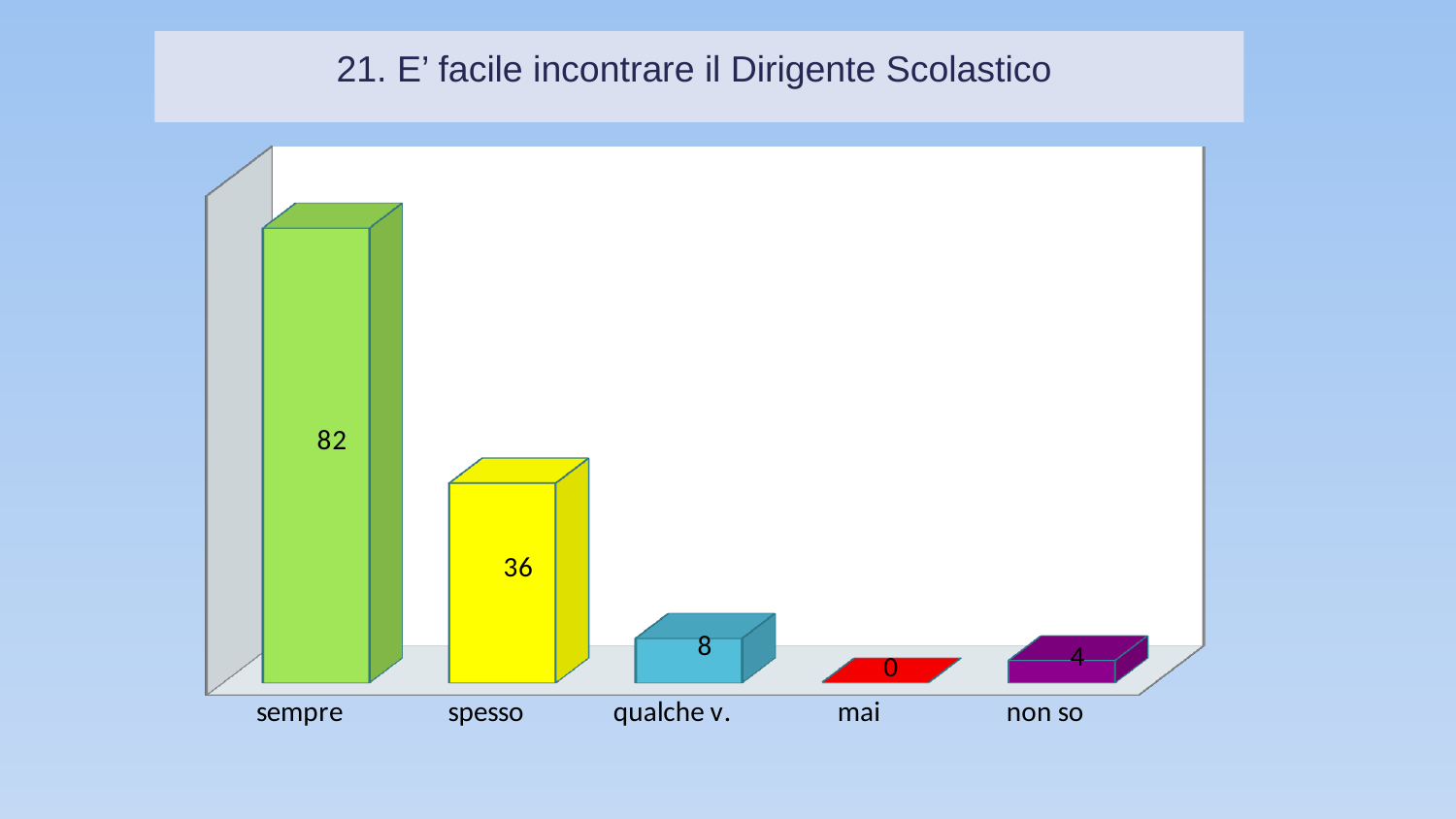
Which category has the lowest value? mai How many categories are shown on the x axis? 5 What is the title of the slide? 21. E' facile incontrare il Dirigente Scolastico What is the difference between the values for "sempre" and "spesso"? 46 What is the value for "qualche v."? 8 What is the value for "sempre"? 82 What is the value for "non so"? 4 Which category has the highest value? sempre What is the value for "mai"? 0 Which is larger, the value for "qualche v." or the value for "non so"? qualche v. What is the value for "spesso"? 36 What kind of chart is shown on the slide? bar chart